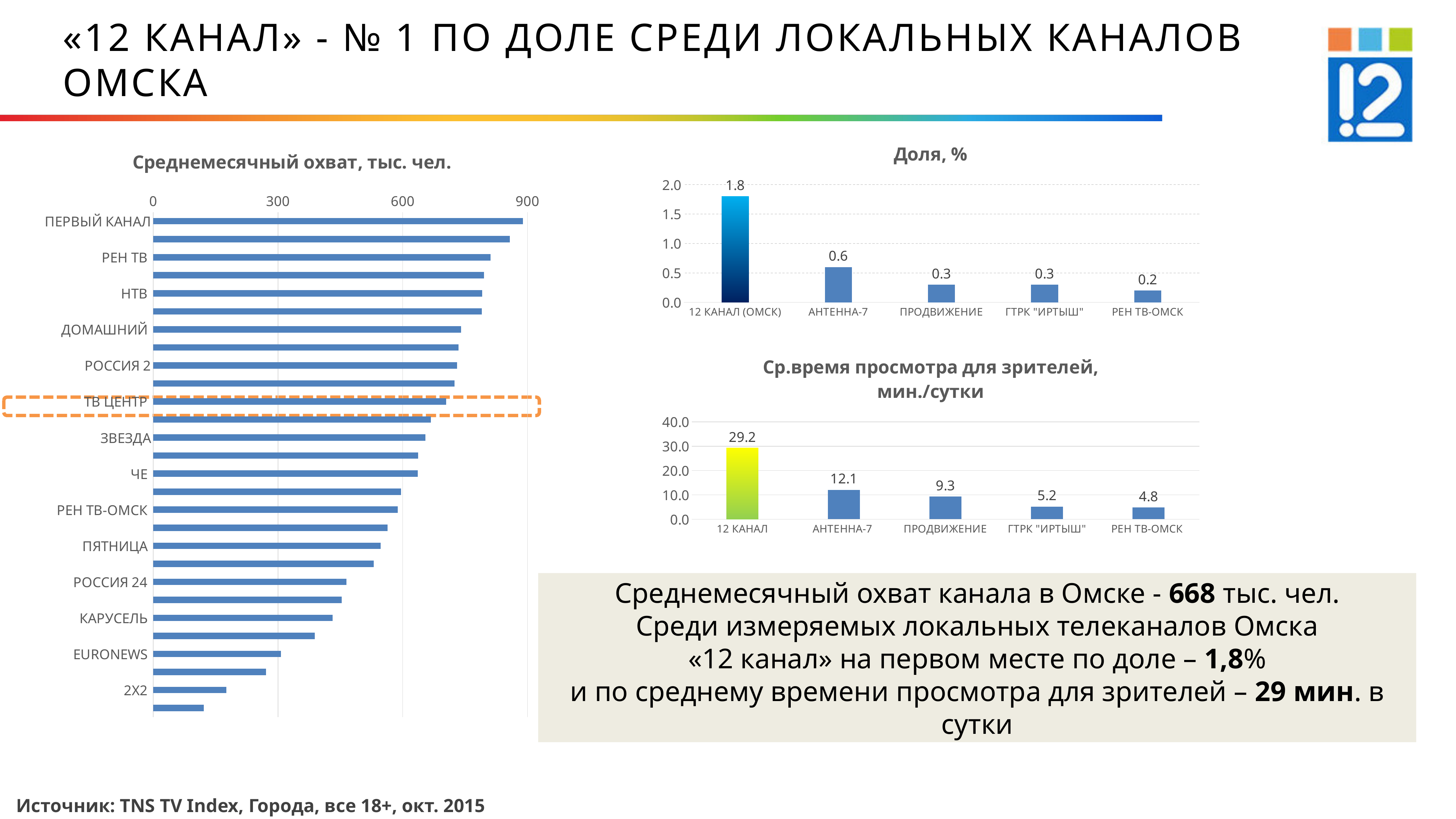
In the chart titled "Доля, %", how many categories are shown? 5 What kind of chart is the one titled "Среднемесячный охват, тыс. чел."? bar chart In the chart titled "Доля, %", which category has the lowest value? РЕН ТВ-ОМСК In the chart titled "Доля, %", what is the difference between 12 КАНАЛ (ОМСК) and АНТЕННА-7? 1.2 In the chart titled "Доля, %", what is the value for АНТЕННА-7? 0.6 In the chart titled "Ср.время просмотра для зрителей, мин./сутки", what is the difference between АНТЕННА-7 and ПРОДВИЖЕНИЕ? 2.8 In the chart titled "Среднемесячный охват, тыс. чел.", is the value for 2X2 greater or less than 300? less In the chart titled "Доля, %", what is the value for 12 КАНАЛ (ОМСК)? 1.8 In the chart titled "Ср.время просмотра для зрителей, мин./сутки", what is the value for 12 КАНАЛ? 29.2 In the chart titled "Ср.время просмотра для зрителей, мин./сутки", which is larger: ПРОДВИЖЕНИЕ or РЕН ТВ-ОМСК? ПРОДВИЖЕНИЕ In the chart titled "Ср.время просмотра для зрителей, мин./сутки", what is the value for ГТРК "ИРТЫШ"? 5.2 In the chart titled "Среднемесячный охват, тыс. чел.", is the value for РЕН ТВ greater or less than 600? greater